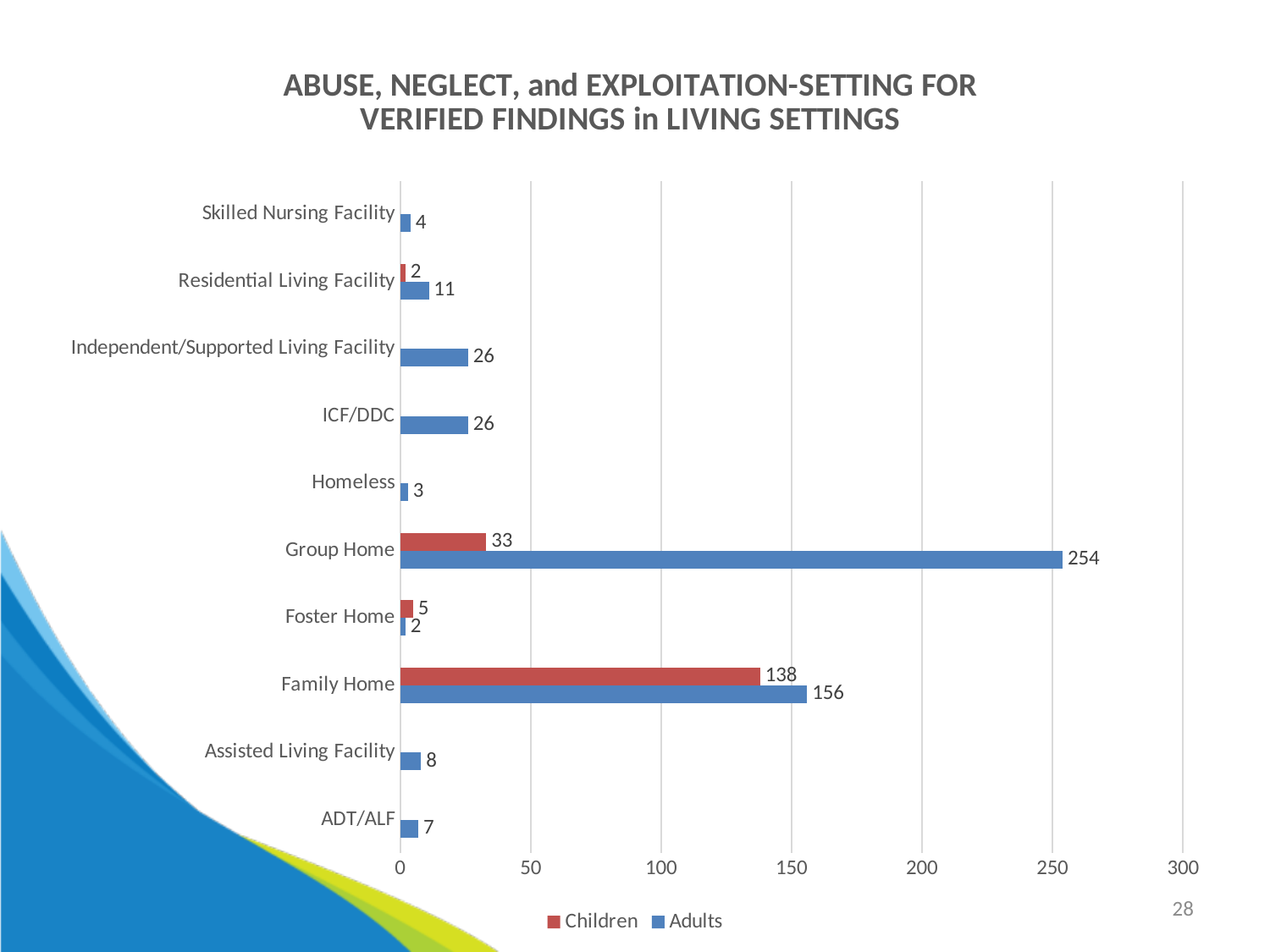
What is the Children value for Family Home? 138 Which category has the highest Adults value? Group Home What is the Adults value for Group Home? 254 Is the Adults value for Group Home greater or less than 250? greater What is the difference between the Adults and Children values for Family Home? 18 Which category has the lowest Adults value? Foster Home How many categories are shown on the y axis? 10 For Foster Home, which is larger, the Children value or the Adults value? Children How many series does the legend list? 2 What kind of chart is shown on the slide? bar chart What colour represents the Children series? red What is the Adults value for Residential Living Facility? 11